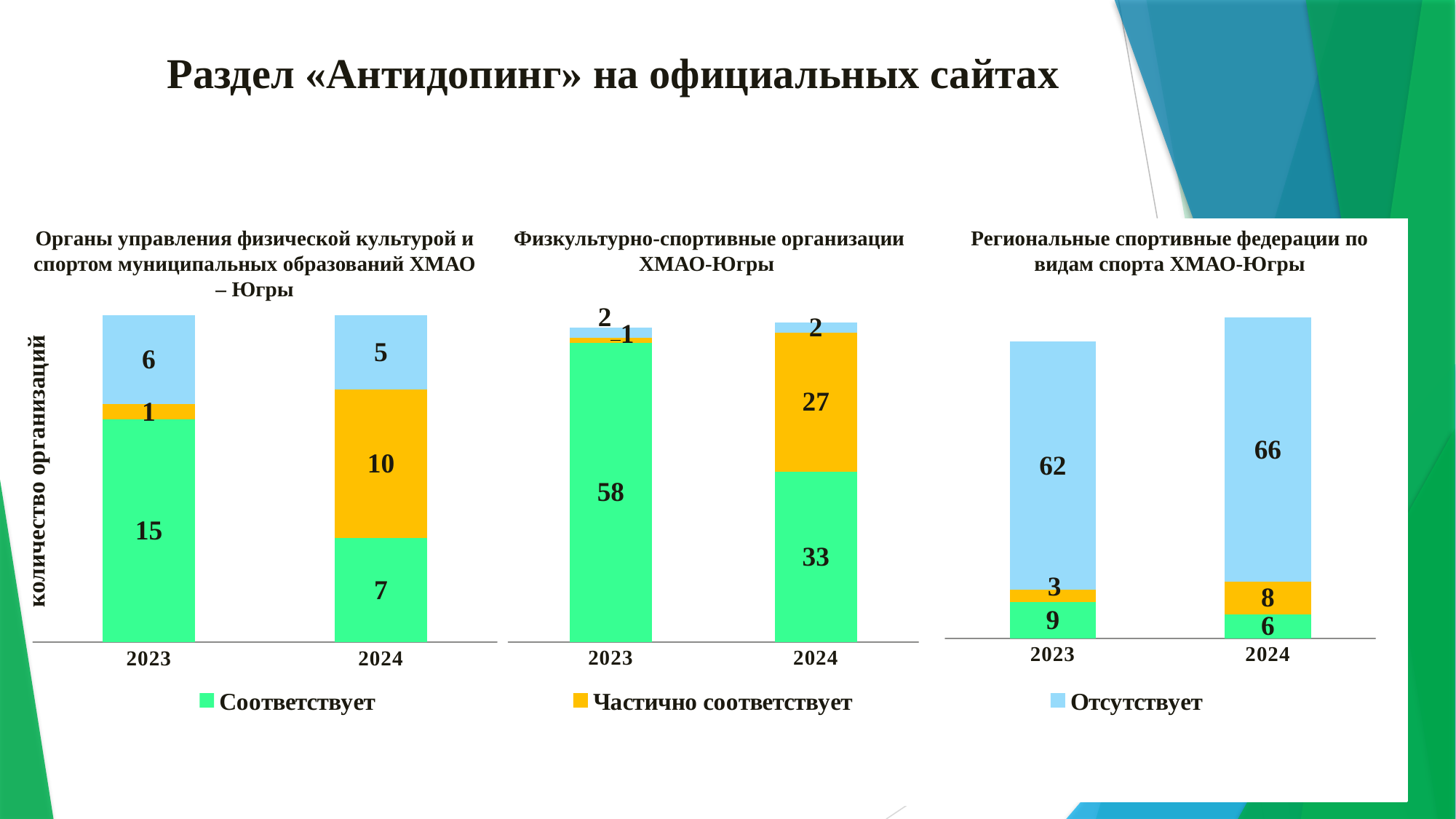
In the left chart (Органы управления физической культурой и спортом муниципальных образований ХМАО – Югры), what is the total of the stacked bar for 2024? 22 In the middle chart (Физкультурно-спортивные организации ХМАО-Югры), what is the value for Соответствует in 2023? 58 What kind of chart is the middle chart (Физкультурно-спортивные организации ХМАО-Югры)? Stacked bar chart In the left chart (Органы управления физической культурой и спортом муниципальных образований ХМАО – Югры), what is the value for Соответствует in 2023? 15 What is the label on the vertical axis of the left chart? количество организаций In the middle chart (Физкультурно-спортивные организации ХМАО-Югры), what is the difference between the Частично соответствует values for 2024 and 2023? 26 In the right chart (Региональные спортивные федерации по видам спорта ХМАО-Югры), what is the total of the stacked bar for 2023? 74 In the right chart (Региональные спортивные федерации по видам спорта ХМАО-Югры), which year has the larger Соответствует value, 2023 or 2024? 2023 In the middle chart (Физкультурно-спортивные организации ХМАО-Югры), what is the total of the stacked bar for 2024? 62 In the right chart (Региональные спортивные федерации по видам спорта ХМАО-Югры), what is the value for Отсутствует in 2024? 66 In the left chart (Органы управления физической культурой и спортом муниципальных образований ХМАО – Югры), what is the value for Частично соответствует in 2024? 10 How many series does the shared legend list? 3